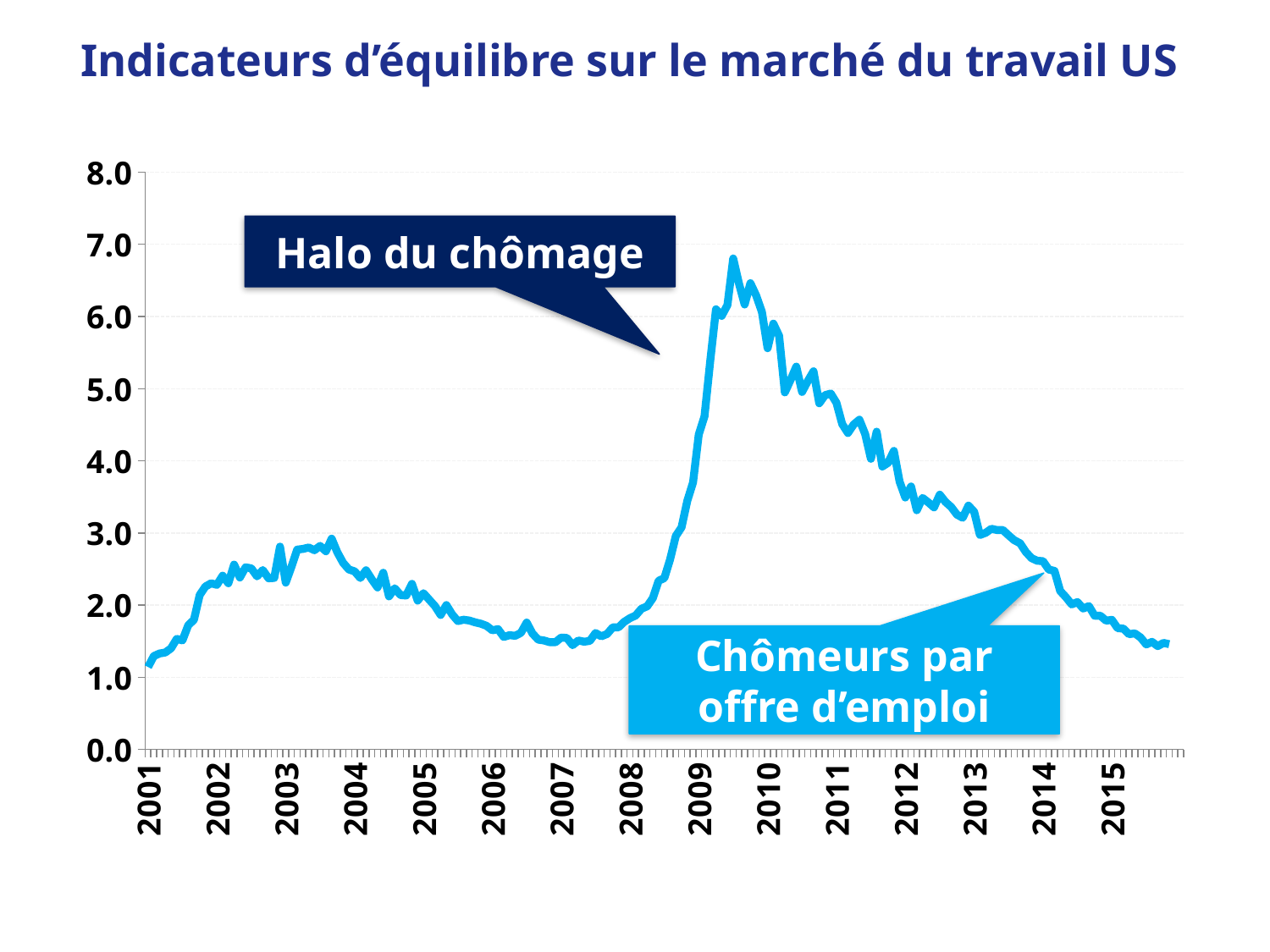
Does the line rise or fall between the 2009 peak and 2015? fall Is the peak value reached in 2009 greater or less than 6.0? greater What is the title of the chart? Indicateurs d'équilibre sur le marché du travail US How many year labels are shown on the x axis? 15 Does the line rise or fall between 2008 and 2009? rise In which year does the line reach its highest value? 2009 Is the value at the 2007 tick greater or less than 2.0? less Is the value at the end of the series in 2015 greater or less than 2.0? less What kind of chart is shown on the slide? line chart Which is larger, the value at the 2010 tick or the value at the 2014 tick? 2010